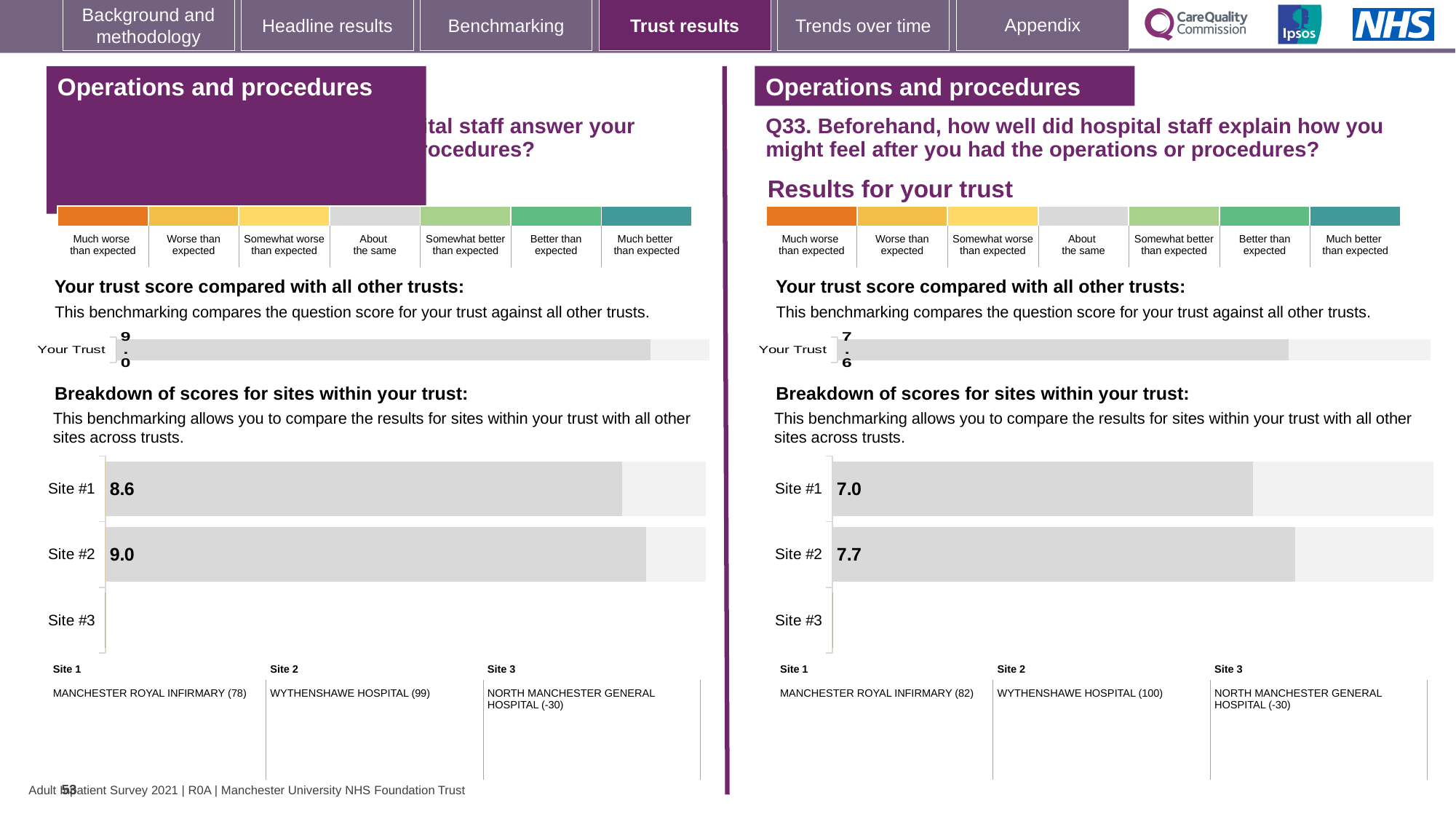
On the right-hand chart (Q33), which site is named as Site 2 in the key below the chart? WYTHENSHAWE HOSPITAL (100) On the right-hand chart (Q33), what is the score for Site #1? 7.0 On the left-hand chart, what is the difference between the Site #2 and Site #1 scores? 0.4 On the right-hand chart (Q33), what is the score for Site #2? 7.7 On the left-hand chart, what is the 'Your Trust' score? 9.0 On the right-hand chart (Q33), what is the 'Your Trust' score? 7.6 On the left-hand chart, how many site categories are listed in the site breakdown? 3 On the right-hand chart (Q33), which site has the higher score, Site #1 or Site #2? Site #2 On the left-hand chart, what is the score for Site #1? 8.6 On the left-hand chart, what is the score for Site #2? 9.0 What type of chart is used for the breakdown of scores for sites on the right-hand side (Q33)? Bar chart On the right-hand chart (Q33), what is the difference between the Site #2 and Site #1 scores? 0.7